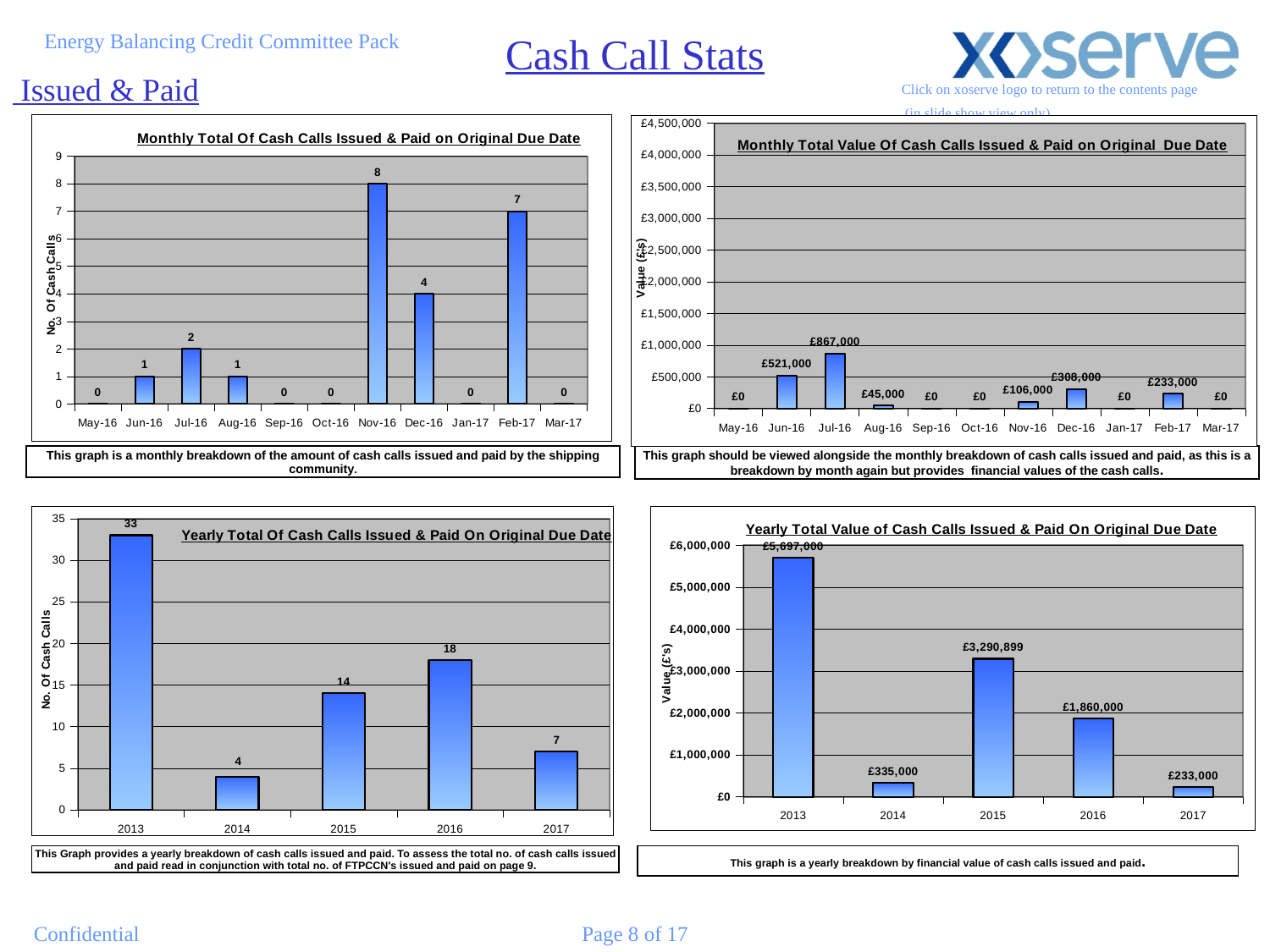
In the 'Monthly Total Value Of Cash Calls Issued & Paid on Original Due Date' chart, what is the difference between the values for Jun-16 and Dec-16? £213,000 In the 'Monthly Total Of Cash Calls Issued & Paid on Original Due Date' chart, which month has the highest value? Nov-16 In the 'Yearly Total Of Cash Calls Issued & Paid On Original Due Date' chart, what is the value for 2016? 18 In the 'Monthly Total Value Of Cash Calls Issued & Paid on Original Due Date' chart, what is the value for Jul-16? £867,000 What kind of chart is the 'Yearly Total Value of Cash Calls Issued & Paid On Original Due Date' chart? Bar chart In the 'Yearly Total Value of Cash Calls Issued & Paid On Original Due Date' chart, which year has the highest value? 2013 In the 'Yearly Total Value of Cash Calls Issued & Paid On Original Due Date' chart, what is the value for 2015? £3,290,899 In the 'Monthly Total Of Cash Calls Issued & Paid on Original Due Date' chart, how many months are shown on the x axis? 11 In the 'Monthly Total Of Cash Calls Issued & Paid on Original Due Date' chart, what is the value for Nov-16? 8 In the 'Monthly Total Value Of Cash Calls Issued & Paid on Original Due Date' chart, which is larger, the value for Nov-16 or the value for Feb-17? Feb-17 In the 'Yearly Total Of Cash Calls Issued & Paid On Original Due Date' chart, which year has the lowest value? 2014 In the 'Yearly Total Of Cash Calls Issued & Paid On Original Due Date' chart, what is the difference between the values for 2013 and 2015? 19